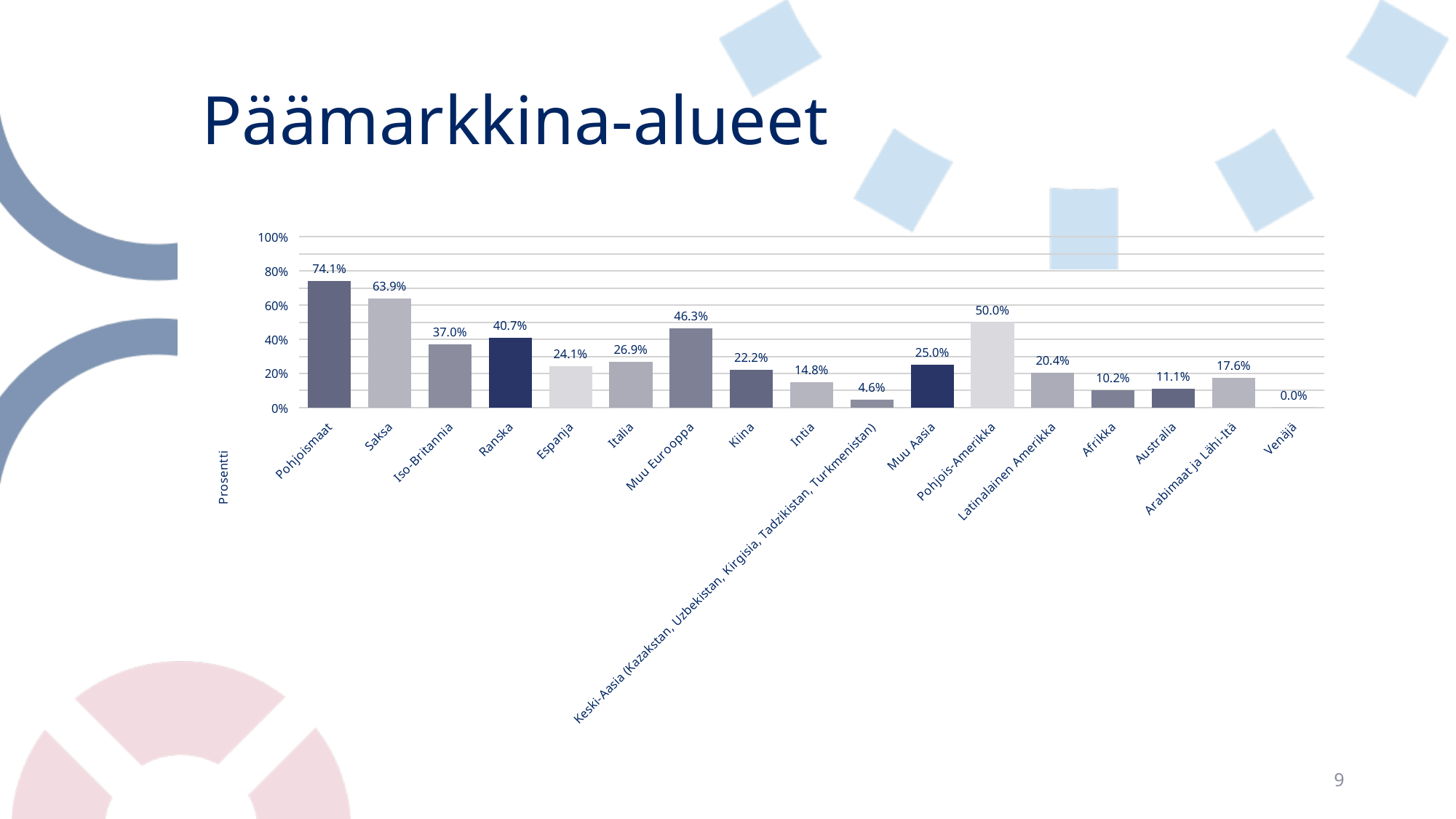
What is the value for Arabimaat ja Lähi-Itä? 17.6% How many categories are shown on the x axis? 17 What is the value for Muu Eurooppa? 46.3% What is the value for Keski-Aasia (Kazakstan, Uzbekistan, Kirgisia, Tadzikistan, Turkmenistan)? 4.6% What is the value for Pohjoismaat? 74.1% What is the label on the vertical axis? Prosentti Which category has the highest value? Pohjoismaat What is the difference between the values for Ranska and Iso-Britannia? 3.7 percentage points What is the difference between the values for Pohjoismaat and Saksa? 10.2 percentage points What kind of chart is shown on the slide? Bar chart Which category has the lowest value? Venäjä Which has a larger value, Pohjois-Amerikka or Muu Eurooppa? Pohjois-Amerikka